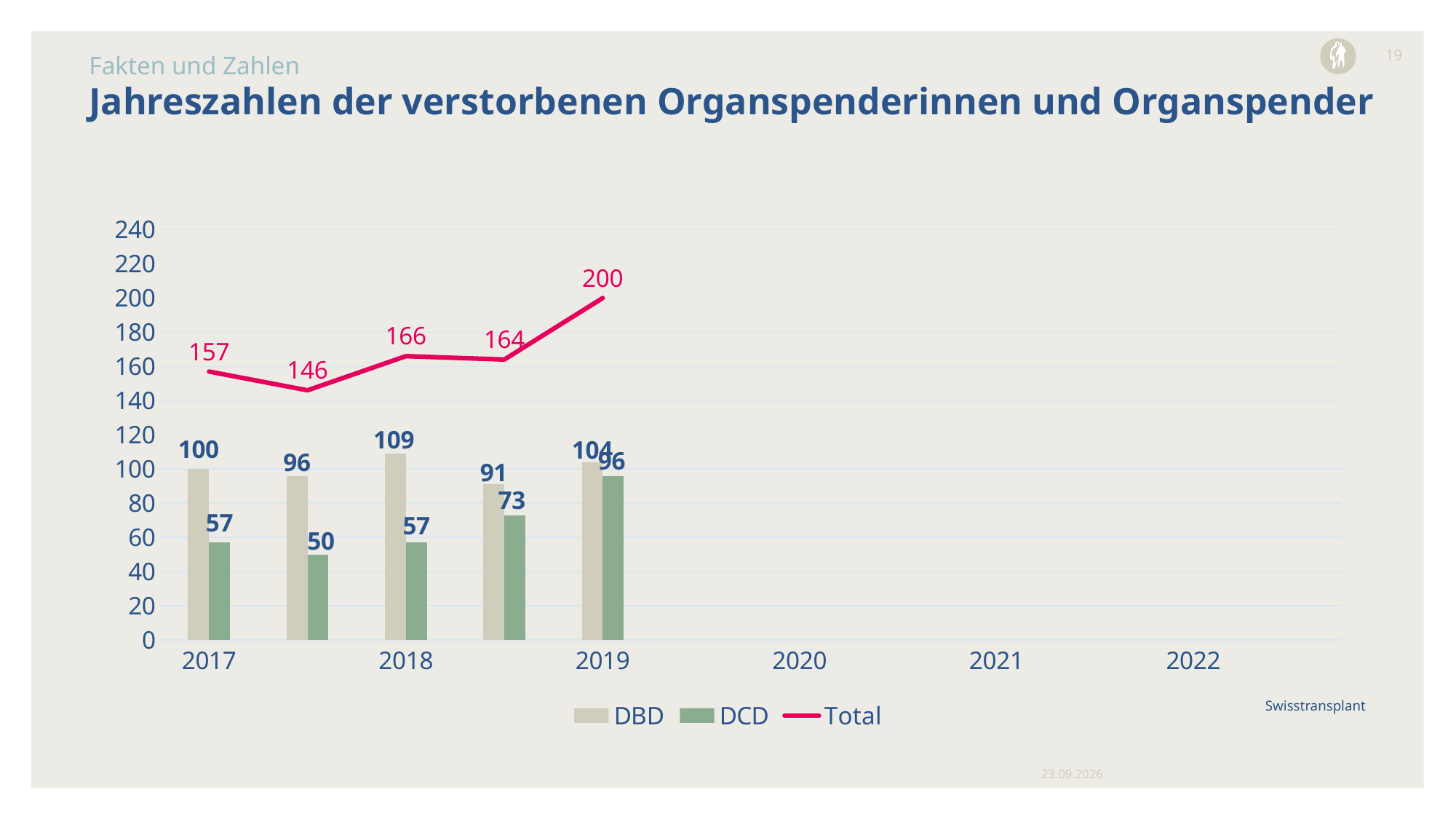
What is the DBD value for 2017? 100 What is the DCD value for 2019? 96 What is the lowest DCD value shown? 50 What is the difference between the DBD and DCD values for 2019? 8 How many groups of bars are plotted on the chart? 5 What is the highest DBD value shown? 109 What is the Total value for 2018? 166 Does the Total line rise or fall between 2017 and 2019 overall? rise What is the lowest value on the Total line? 146 How many series does the legend list? 3 Which is larger in 2018, the DBD value or the DCD value? DBD What is the highest value on the Total line? 200